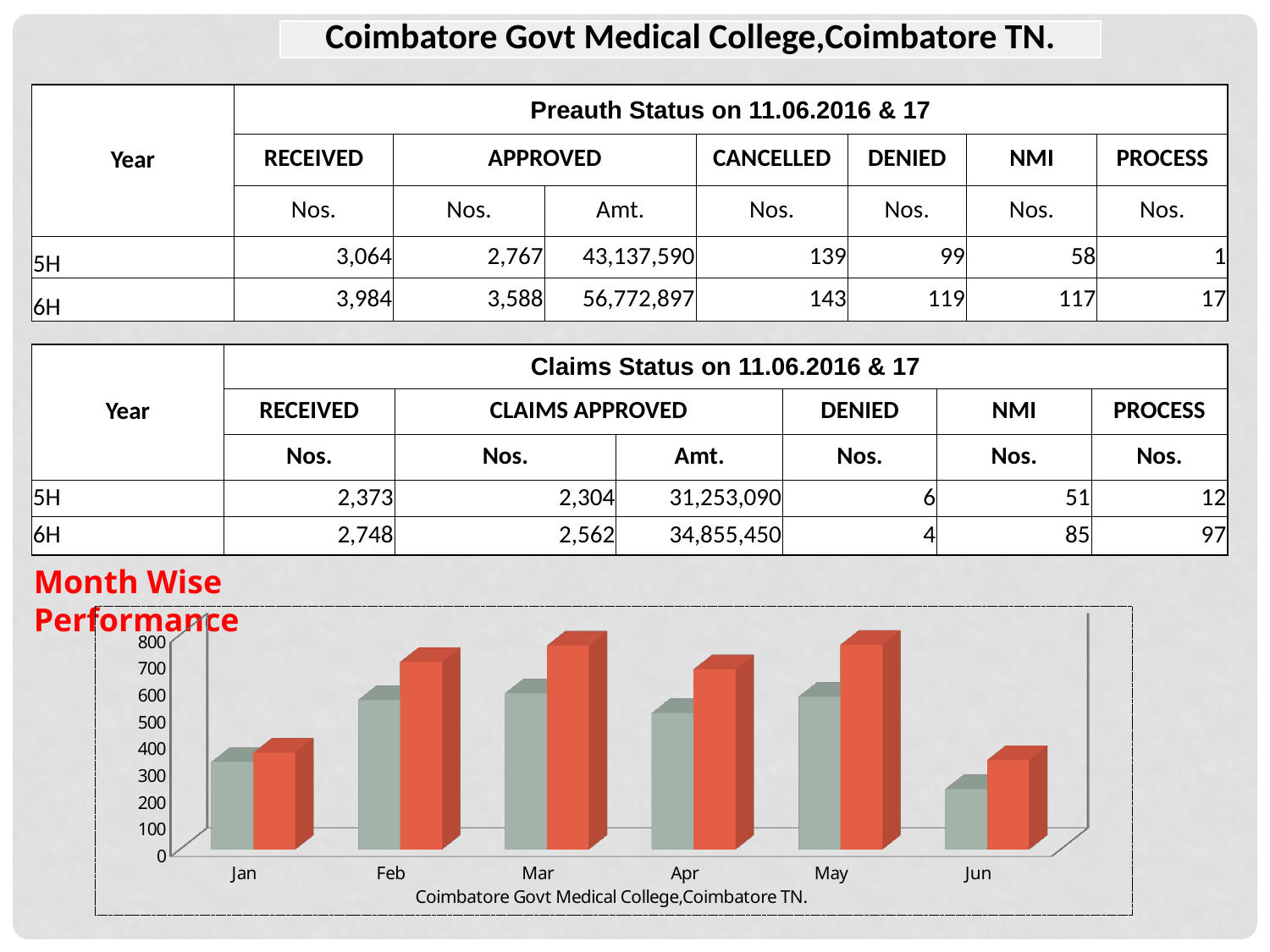
What kind of chart is shown under the heading 'Month Wise Performance'? bar chart In the Month Wise Performance chart, is the grey bar for Jan greater or less than 400? less In the Month Wise Performance chart, is the grey bar for Jun greater or less than 300? less In the Month Wise Performance chart, is the red bar for Feb greater or less than 600? greater What text appears below the month labels on the x axis of the Month Wise Performance chart? Coimbatore Govt Medical College,Coimbatore TN. How many months are shown on the x axis of the Month Wise Performance chart? 6 In the Month Wise Performance chart, which month has the lowest red bar? Jun How many bars are plotted for each month in the Month Wise Performance chart? 2 In the Month Wise Performance chart, do the grey bars rise or fall from Jan to Mar? rise In the Month Wise Performance chart, which is larger for Mar, the grey bar or the red bar? the red bar In the Month Wise Performance chart, which month has the lowest grey bar? Jun